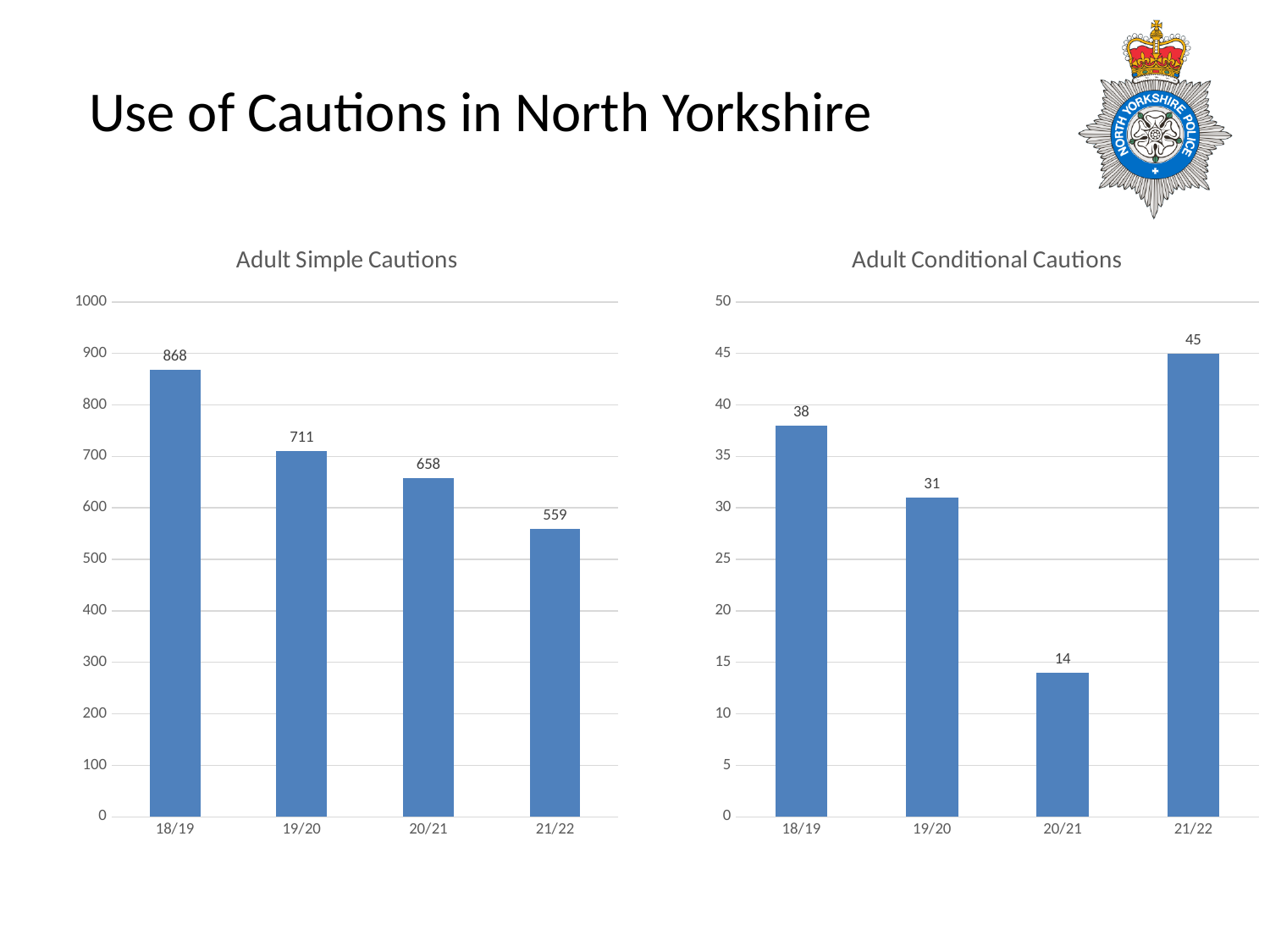
In the Adult Conditional Cautions chart, which is larger, the value for 18/19 or the value for 19/20? 18/19 How many years are shown on the x axis of the Adult Simple Cautions chart? 4 In the Adult Conditional Cautions chart, what is the difference between the values for 21/22 and 20/21? 31 In the Adult Simple Cautions chart, what is the value for 21/22? 559 In the Adult Conditional Cautions chart, what is the value for 20/21? 14 In the Adult Simple Cautions chart, is the value for 20/21 greater or less than 700? less In the Adult Simple Cautions chart, what is the difference between the values for 18/19 and 19/20? 157 In the Adult Simple Cautions chart, do the values rise or fall from 18/19 to 21/22? fall What kind of chart is the Adult Conditional Cautions chart? bar chart In the Adult Conditional Cautions chart, which year has the highest value? 21/22 In the Adult Simple Cautions chart, which year has the lowest value? 21/22 In the Adult Simple Cautions chart, what is the value for 18/19? 868